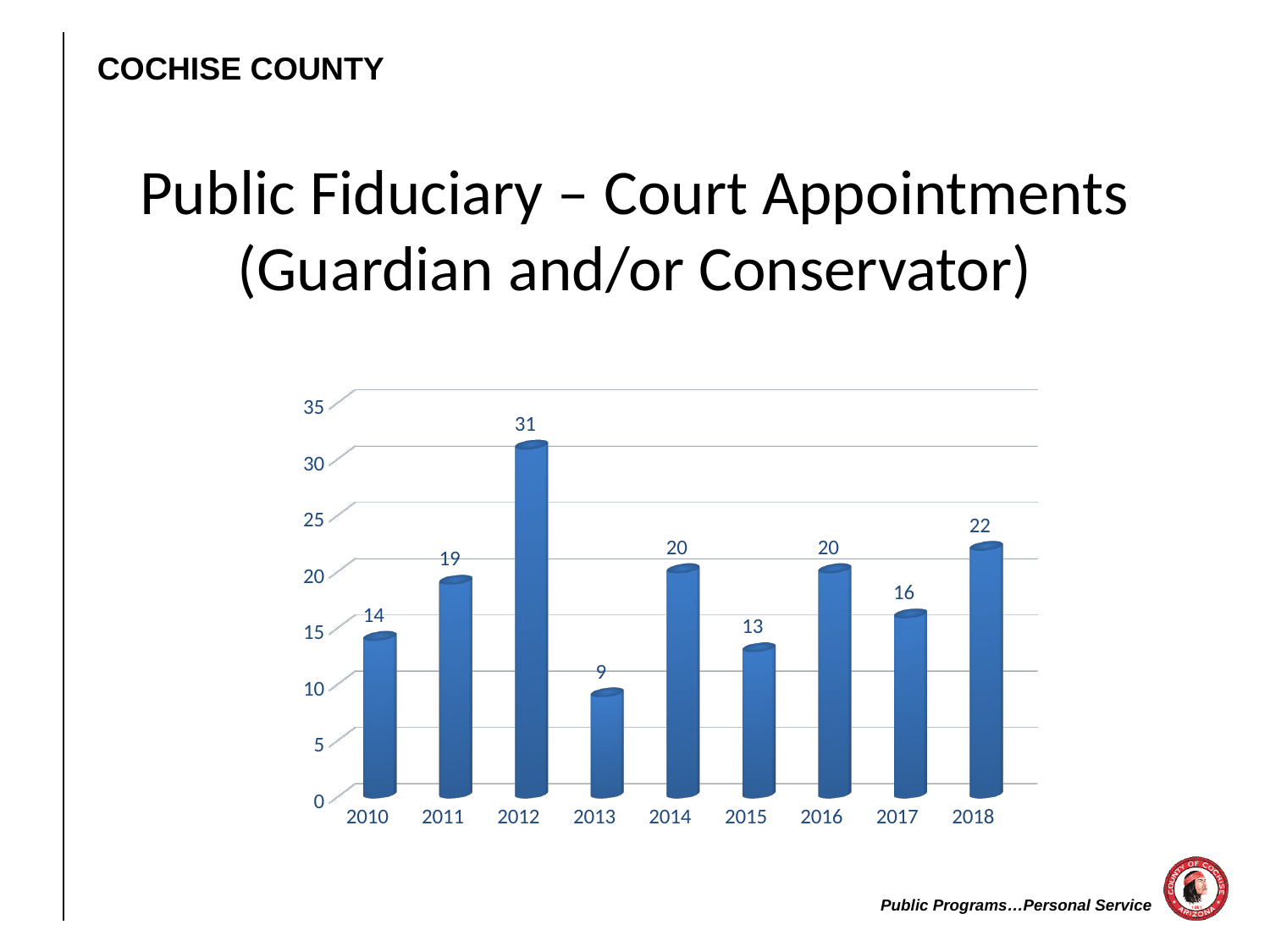
Which year has the lowest value? 2013 What is the difference between the values for 2012 and 2013? 22 Which year has the highest value? 2012 What is the value for 2017? 16 Do the values rise or fall from 2013 to 2014? rise What is the difference between the values for 2018 and 2010? 8 What is the value for 2012? 31 What is the title of the slide containing the chart? Public Fiduciary – Court Appointments (Guardian and/or Conservator) Which is larger, the value for 2011 or the value for 2018? 2018 Is the value for 2015 greater or less than 15? less How many years are shown on the x axis? 9 What kind of chart is shown on the slide? bar chart